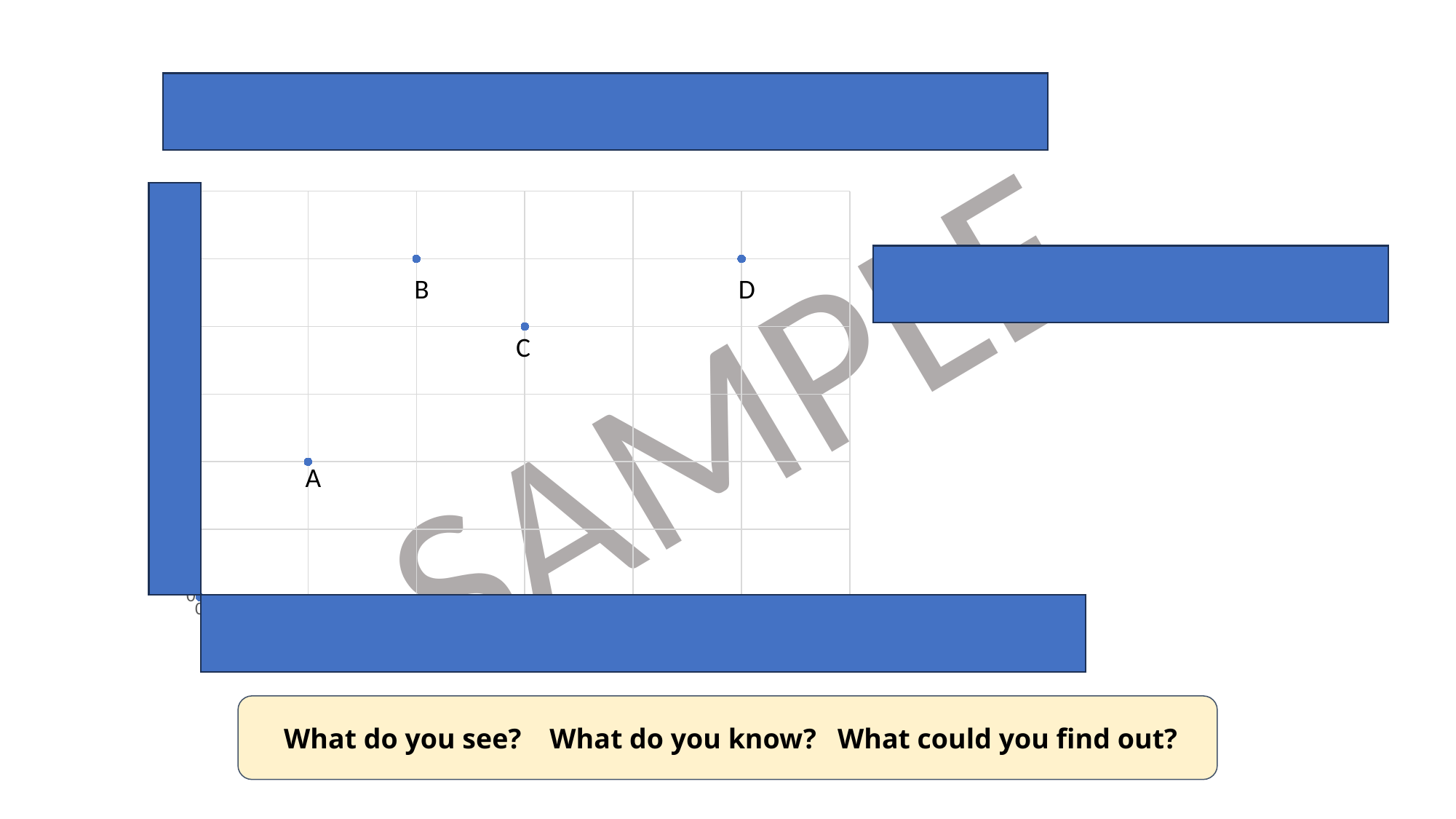
Which point is plotted higher, A or B? B Which point is plotted higher, A or C? C Which labelled point is plotted lowest on the chart? A What kind of chart is shown on the slide? scatter chart Do the points rise or fall from B to C along the x axis? fall Which labelled point is furthest to the left on the chart? A How many labelled data points are plotted on the chart? 4 Which labelled point is furthest to the right on the chart? D Do the points rise or fall from A to B along the x axis? rise Which point is plotted higher, C or D? D